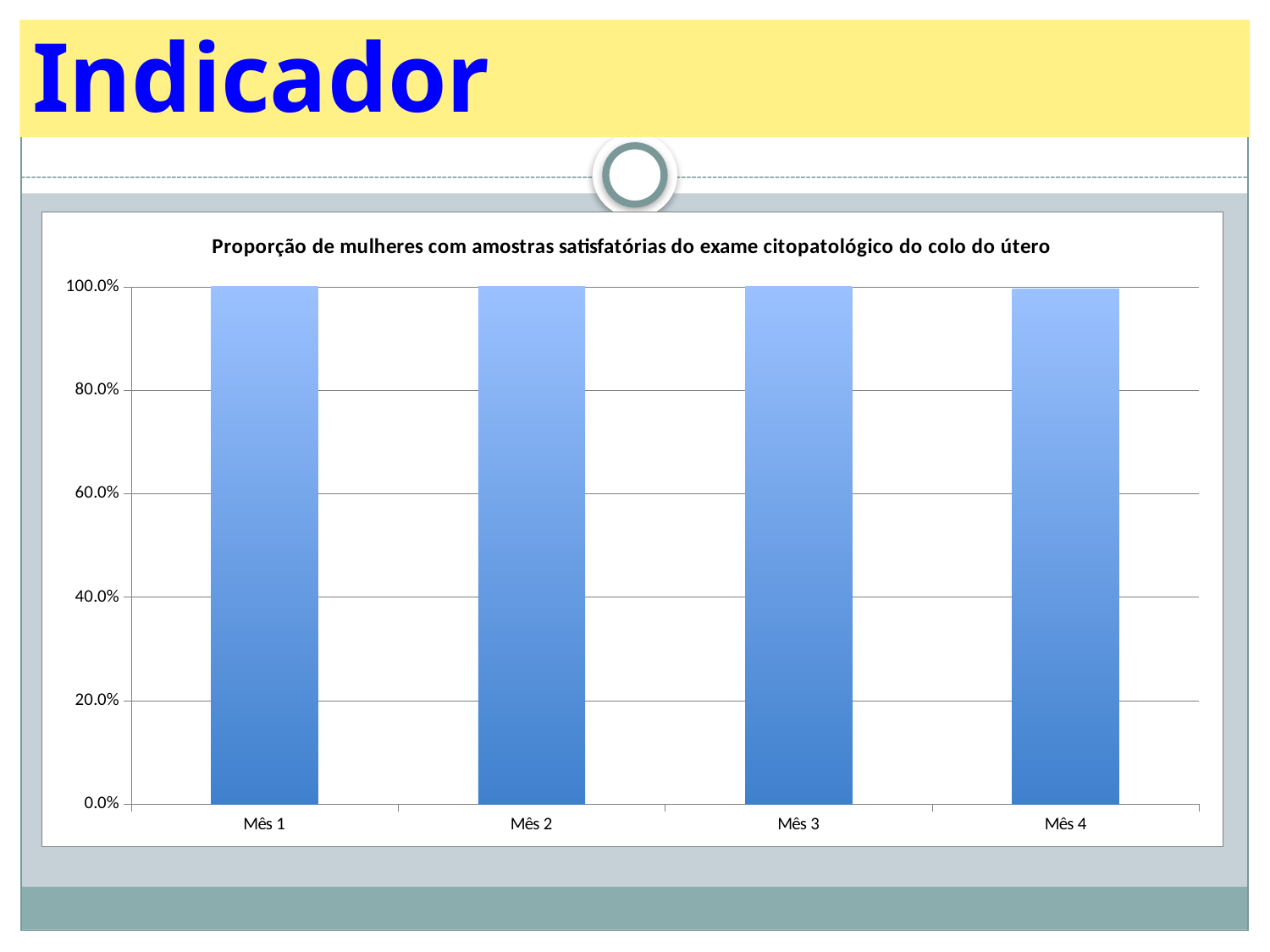
What is the label of the first category on the x axis? Mês 1 What kind of chart is shown on the slide? bar chart What is the title of the chart? Proporção de mulheres com amostras satisfatórias do exame citopatológico do colo do útero Is the value for Mês 4 greater or less than 80.0%? greater How many categories (months) are shown on the x axis of the chart? 4 Which month has the lowest value in the chart? Mês 4 Is the value for Mês 2 greater or less than 60.0%? greater What is the highest value shown on the y axis of the chart? 100.0%